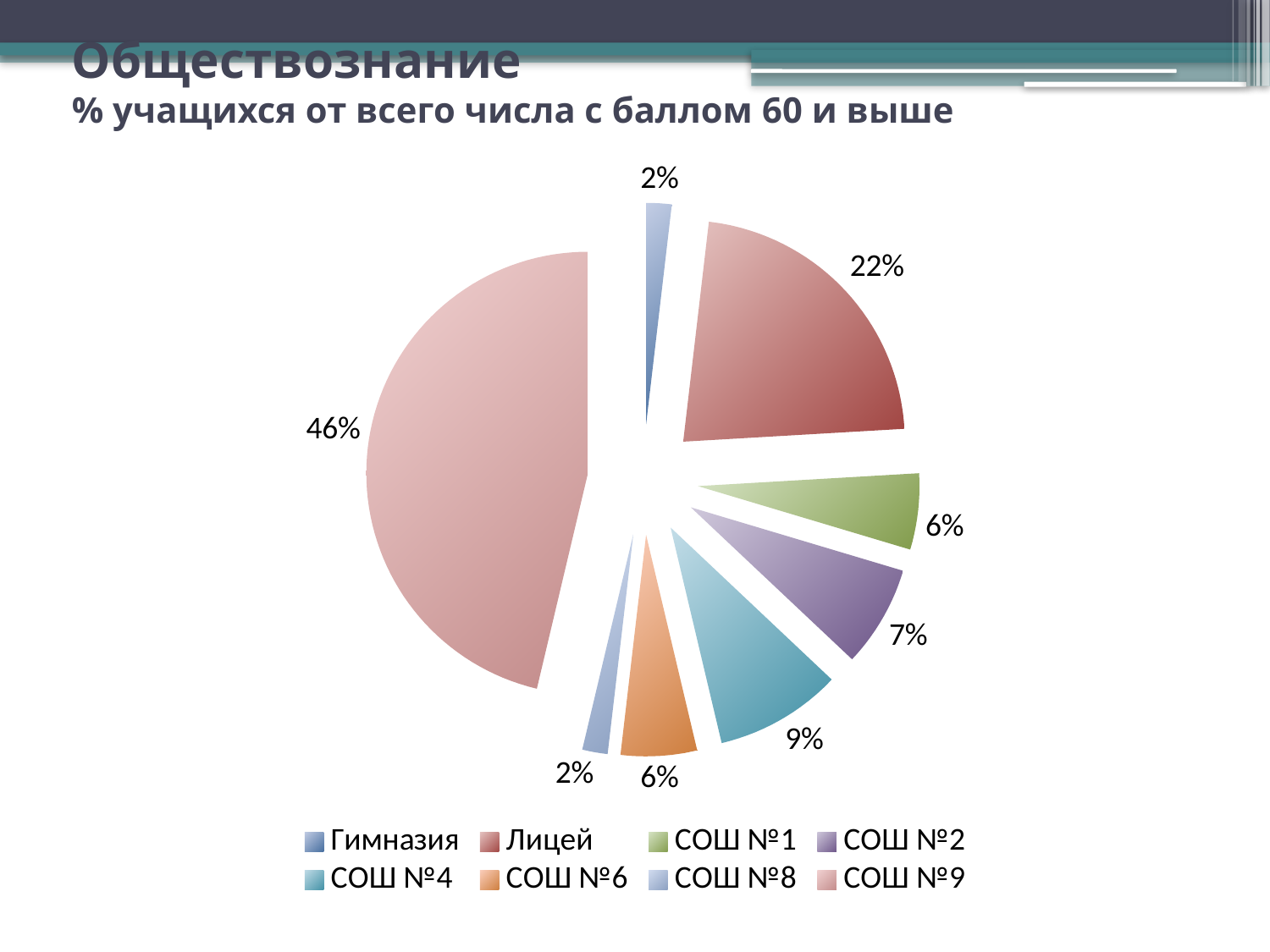
How many slices does the pie chart have? 8 What percentage does the slice for Лицей show? 22% What percentage does the slice for СОШ №2 show? 7% How many entries does the legend list? 8 Which school has the largest slice of the pie? СОШ №9 What is the difference in percentage points between the slices for СОШ №9 and Лицей? 24 What percentage does the slice for СОШ №1 show? 6% Which school has the larger share, Лицей or СОШ №4? Лицей What percentage does the slice for СОШ №9 show? 46% What is the title of the chart on the slide? Обществознание What percentage does the slice for СОШ №4 show? 9% What type of chart is shown on the slide? pie chart